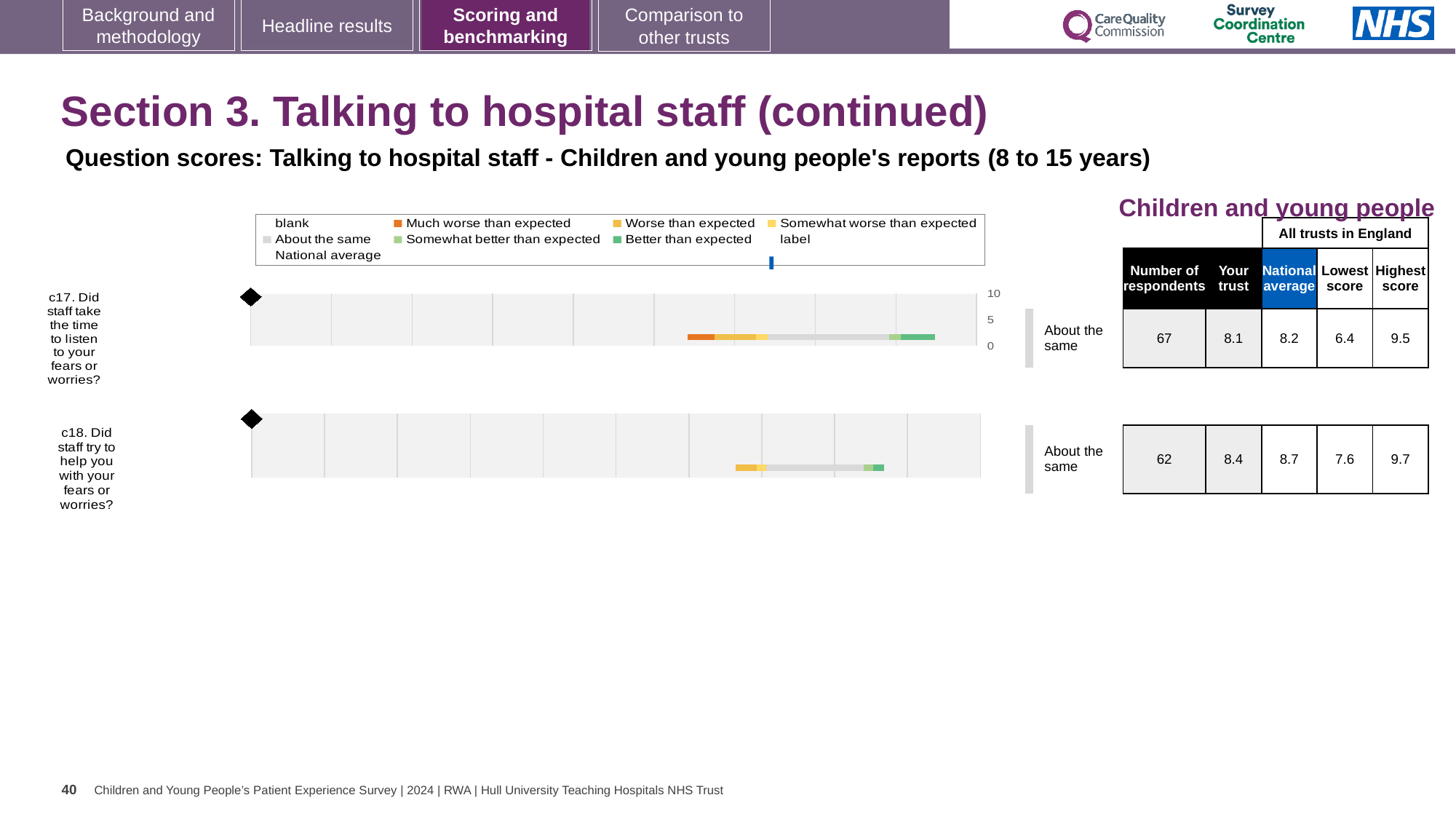
For c17, what is the national average score? 8.2 For c18, what is the national average score? 8.7 What benchmark category is shown next to the c17 chart? About the same For c17 (Did staff take the time to listen to your fears or worries?), what is the 'Your trust' score? 8.1 What is the highest score among all trusts in England for c18? 9.7 What kind of chart is used to show the question scores for c17 and c18? bar chart How many respondents answered c17? 67 For c18, what is the difference between the national average and the 'Your trust' score? 0.3 How many entries does the chart legend list? 9 For c18 (Did staff try to help you with your fears or worries?), what is the 'Your trust' score? 8.4 How many survey questions are plotted on the slide? 2 Which question has the higher 'Your trust' score, c17 or c18? c18